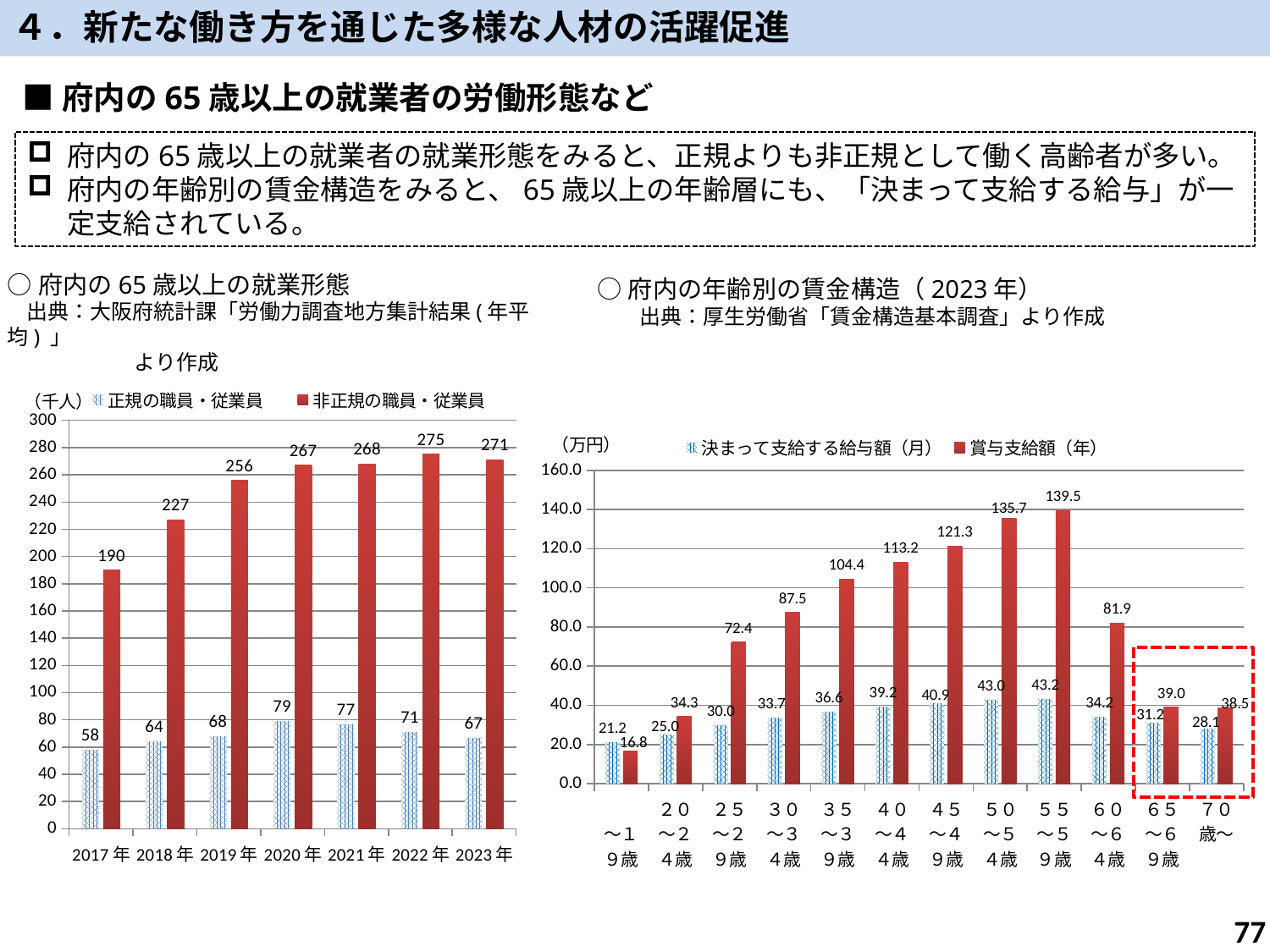
「府内の65歳以上の就業形態」のグラフには何年分のデータがありますか。 7 「府内の年齢別の賃金構造（2023年）」のグラフで、賞与支給額（年）が最も低い年齢層はどれですか。 ～19歳 「府内の年齢別の賃金構造（2023年）」のグラフで、55～59歳の賞与支給額（年）はいくつですか。 139.5 「府内の65歳以上の就業形態」のグラフで、2023年の非正規の職員・従業員の値はいくつですか。 271 「府内の65歳以上の就業形態」のグラフで、非正規の職員・従業員は2017年から2020年にかけて増加していますか、減少していますか。 増加 「府内の年齢別の賃金構造（2023年）」のグラフはどの種類のグラフですか。 棒グラフ 「府内の年齢別の賃金構造（2023年）」のグラフで、65～69歳の決まって支給する給与額（月）はいくつですか。 31.2 「府内の65歳以上の就業形態」のグラフで、非正規の職員・従業員が最も多い年はどれですか。 2022年 「府内の65歳以上の就業形態」のグラフで、2017年の正規の職員・従業員の値はいくつですか。 58 「府内の65歳以上の就業形態」のグラフで、正規の職員・従業員が最も多い年はどれですか。 2020年 「府内の65歳以上の就業形態」のグラフで、2023年の非正規と正規の職員・従業員の差はいくつですか。 204 「府内の年齢別の賃金構造（2023年）」のグラフで、凡例にはいくつの系列がありますか。 2